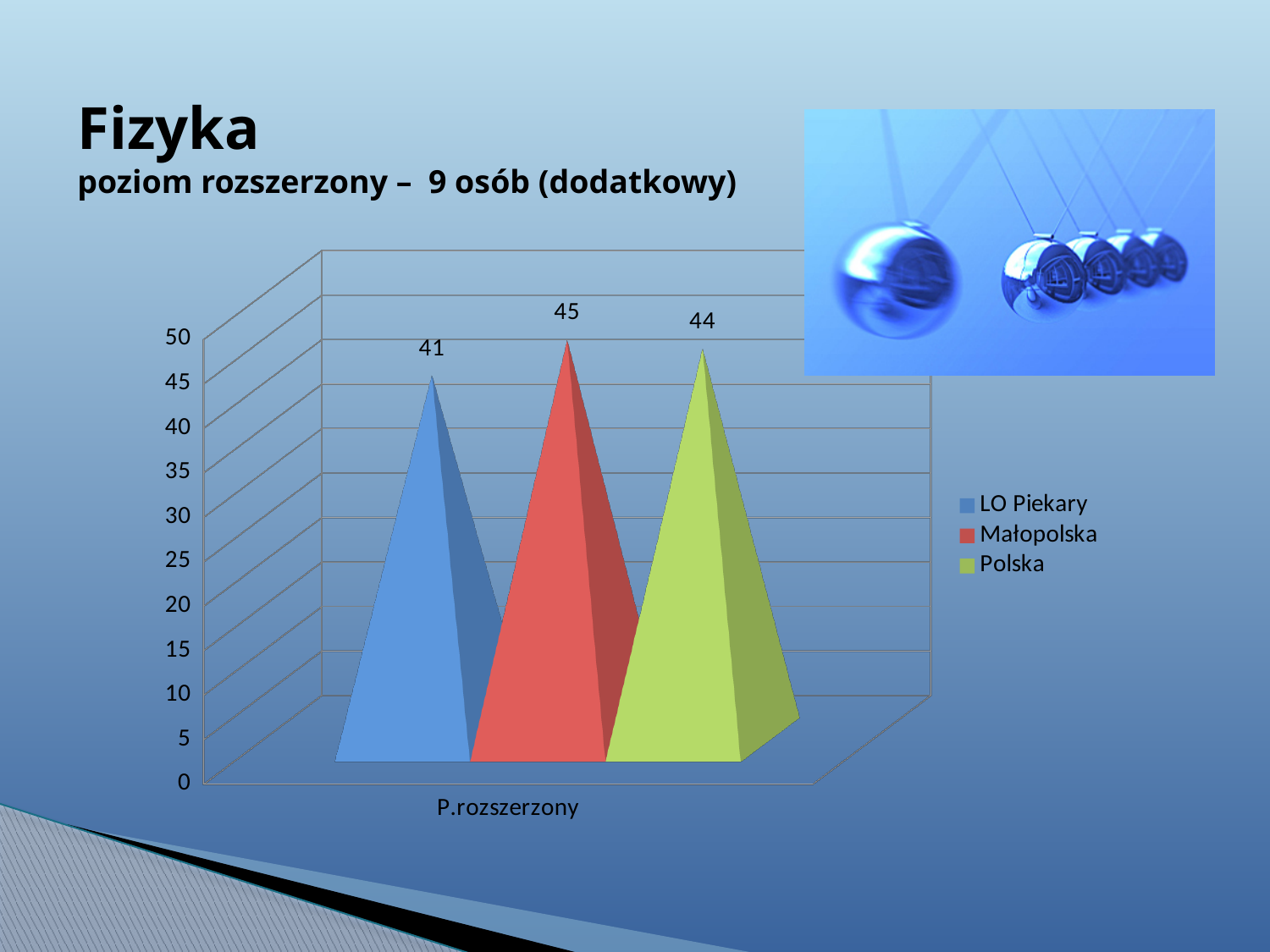
What kind of chart is shown on the slide? bar chart Which series has the lowest value? LO Piekary Which is larger, the value for Polska or the value for LO Piekary? Polska What is the value for Małopolska in the P.rozszerzony category? 45 What is the difference between the Polska value and the LO Piekary value? 3 What is the value for Polska in the P.rozszerzony category? 44 What is the difference between the Małopolska value and the LO Piekary value? 4 How many series does the legend list? 3 Is the value for LO Piekary greater or less than 45? less What is the label of the category on the x axis? P.rozszerzony What is the value for LO Piekary in the P.rozszerzony category? 41 Which series has the highest value? Małopolska